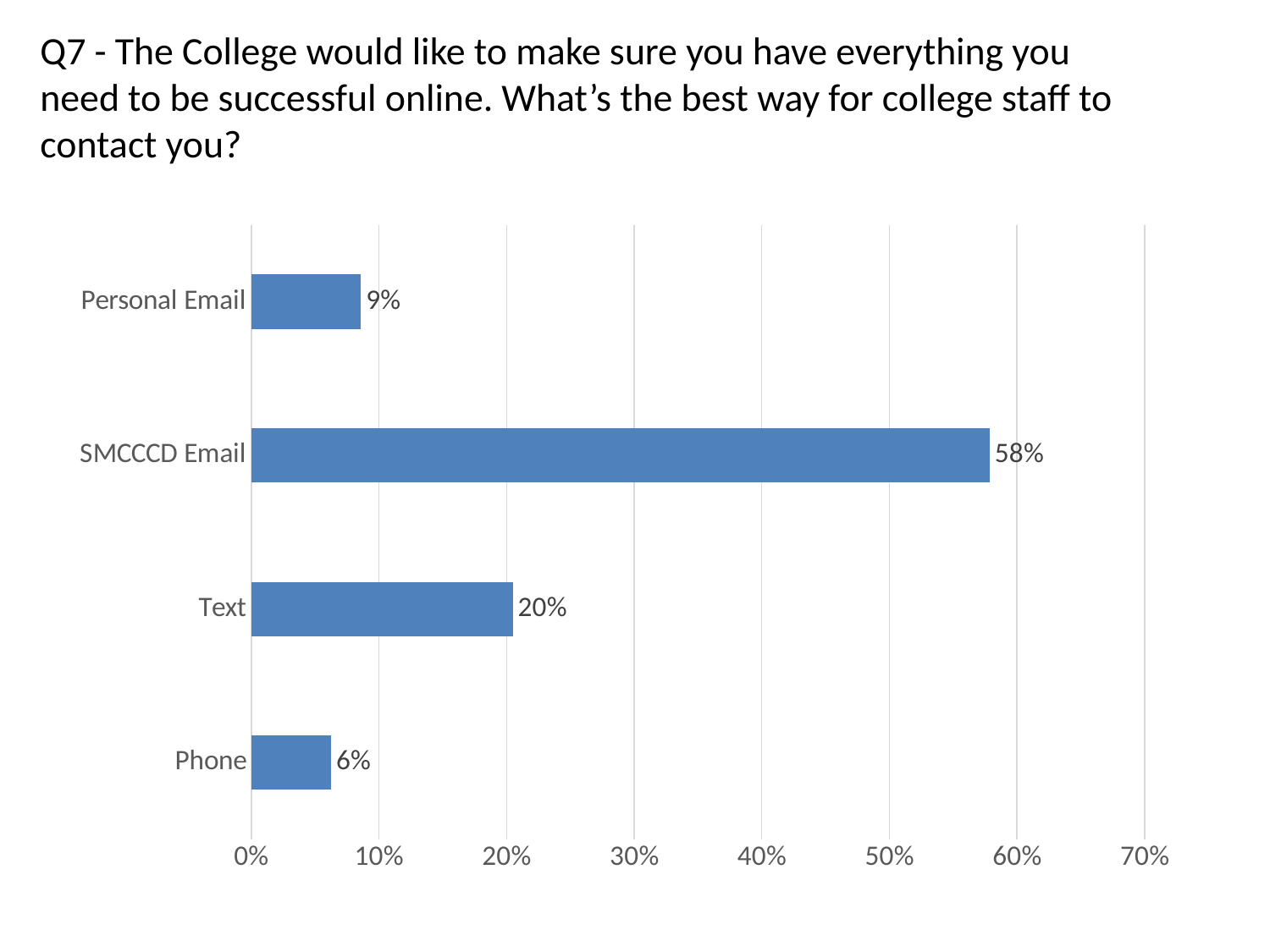
Is the value for SMCCCD Email greater or less than 50%? greater Which contact method has the highest percentage? SMCCCD Email What is the value shown for Phone? 6% What kind of chart is shown on the slide? Bar chart Which is larger, the value for Text or the value for Personal Email? Text What percentage of respondents chose SMCCCD Email as the best way for college staff to contact them? 58% What is the difference in percentage points between SMCCCD Email and Text? 38 What is the value shown for Text? 20% What is the value shown for Personal Email? 9% How many contact methods are shown in the chart? 4 What is the difference in percentage points between Personal Email and Phone? 3 Which contact method has the lowest percentage? Phone